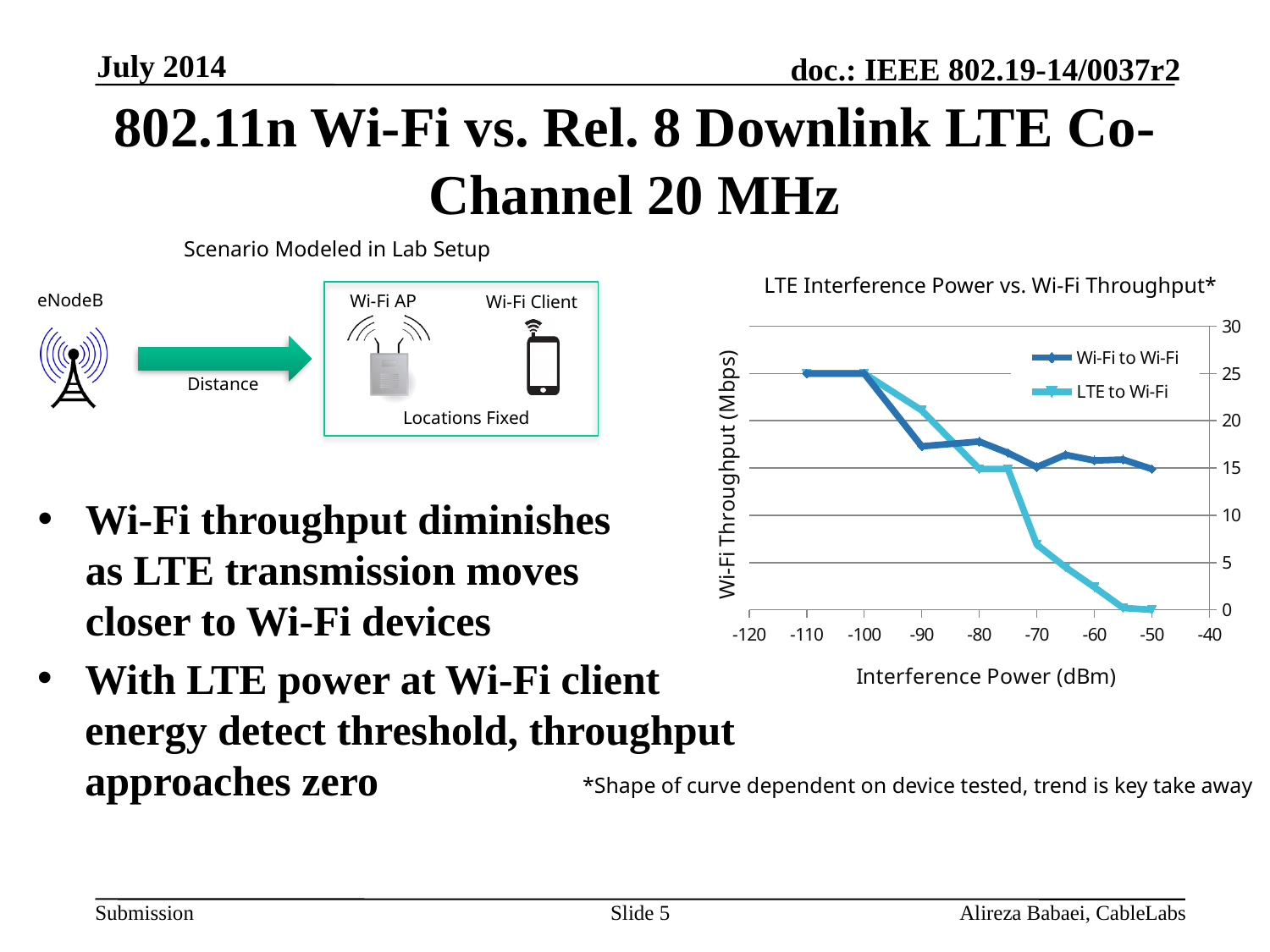
Is the LTE to Wi-Fi value at -80 dBm greater or less than 20? less What is the label of the chart's y axis? Wi-Fi Throughput (Mbps) At -60 dBm, which series has the lower Wi-Fi throughput, Wi-Fi to Wi-Fi or LTE to Wi-Fi? LTE to Wi-Fi Does the LTE to Wi-Fi throughput rise or fall as interference power increases from -110 dBm to -50 dBm? fall Is the LTE to Wi-Fi value at -60 dBm greater or less than 5? less Is the Wi-Fi to Wi-Fi value at -110 dBm greater or less than 20? greater What kind of chart is shown on the slide? line chart How many series does the chart legend list? 2 What is the title of the chart? LTE Interference Power vs. Wi-Fi Throughput* At -50 dBm, which series has the higher Wi-Fi throughput, Wi-Fi to Wi-Fi or LTE to Wi-Fi? Wi-Fi to Wi-Fi